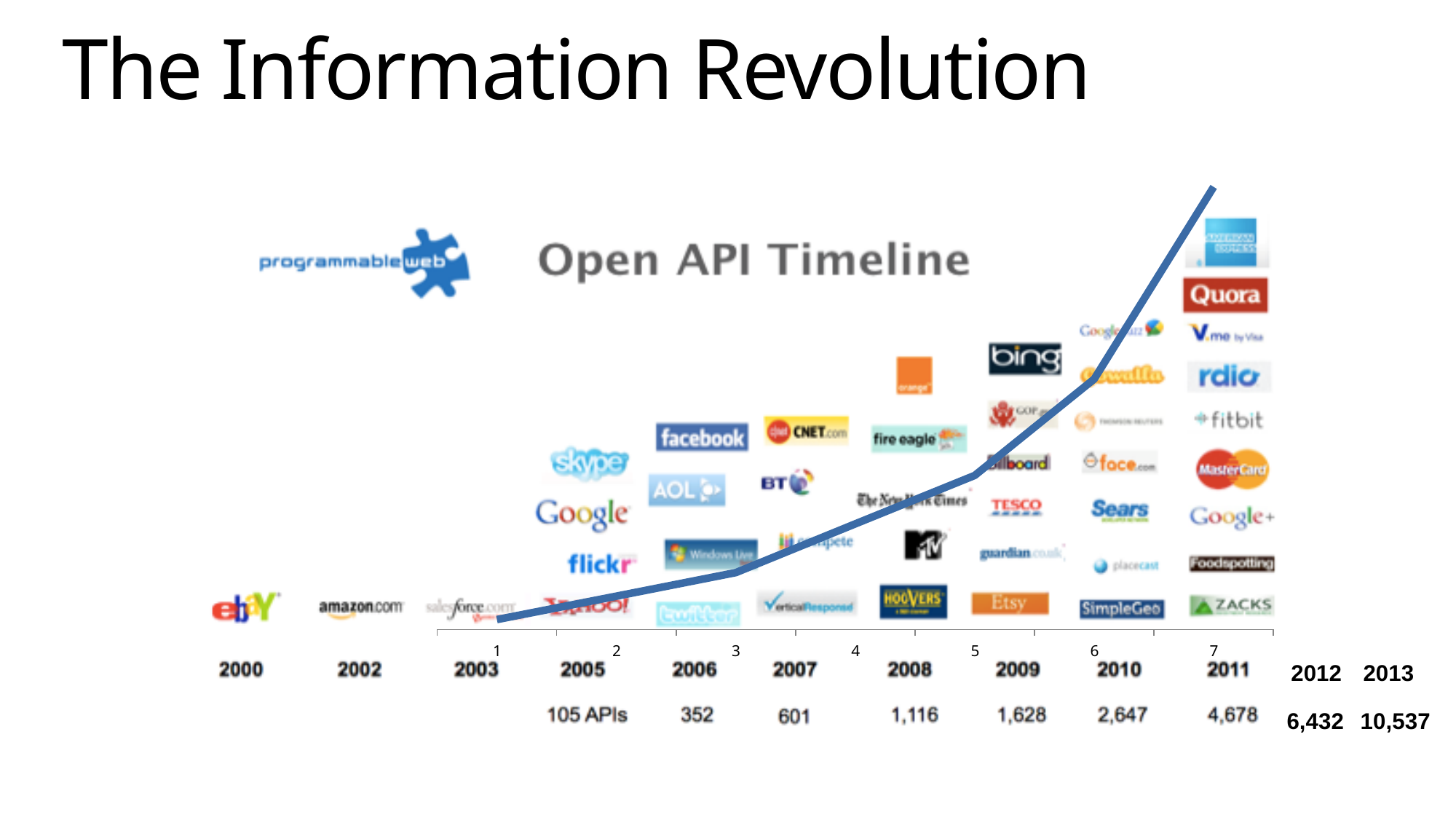
What is the difference between the number of APIs in 2013 and 2012? 4,105 What is the number of APIs shown for 2011? 4,678 What is the number of APIs shown for 2013? 10,537 Which year has the highest number of APIs shown? 2013 Which year has the lowest number of APIs shown? 2005 Which year has more APIs, 2009 or 2010? 2010 What kind of chart is overlaid on the Open API Timeline? line chart What is the title shown on the timeline image? Open API Timeline Does the number of APIs rise or fall over the years shown? rise What is the difference between the number of APIs in 2011 and 2010? 2,031 How many APIs are listed for 2005? 105 APIs What is the number of APIs shown for 2008? 1,116